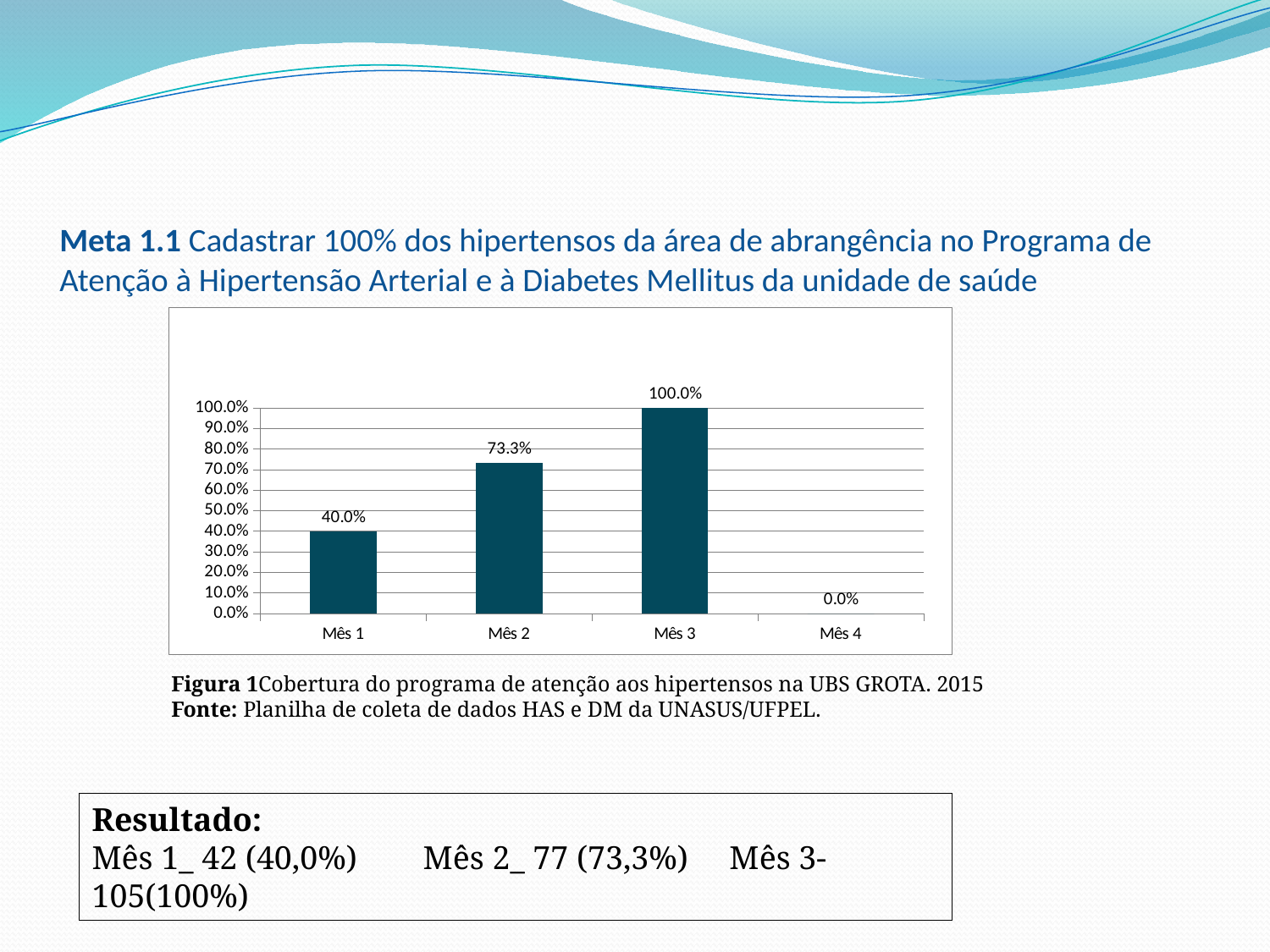
Which month has the highest value? Mês 3 Do the values rise or fall from Mês 1 to Mês 3? Rise What is the value for Mês 4? 0.0% What is the value for Mês 2? 73.3% What is the value for Mês 3? 100.0% What is the difference between the values for Mês 3 and Mês 2? 26.7% How many months are shown on the x axis? 4 Which is larger, the value for Mês 1 or the value for Mês 2? Mês 2 Which month has the lowest value? Mês 4 What kind of chart is shown on the slide? Bar chart What is the difference between the values for Mês 2 and Mês 1? 33.3% What is the value for Mês 1? 40.0%